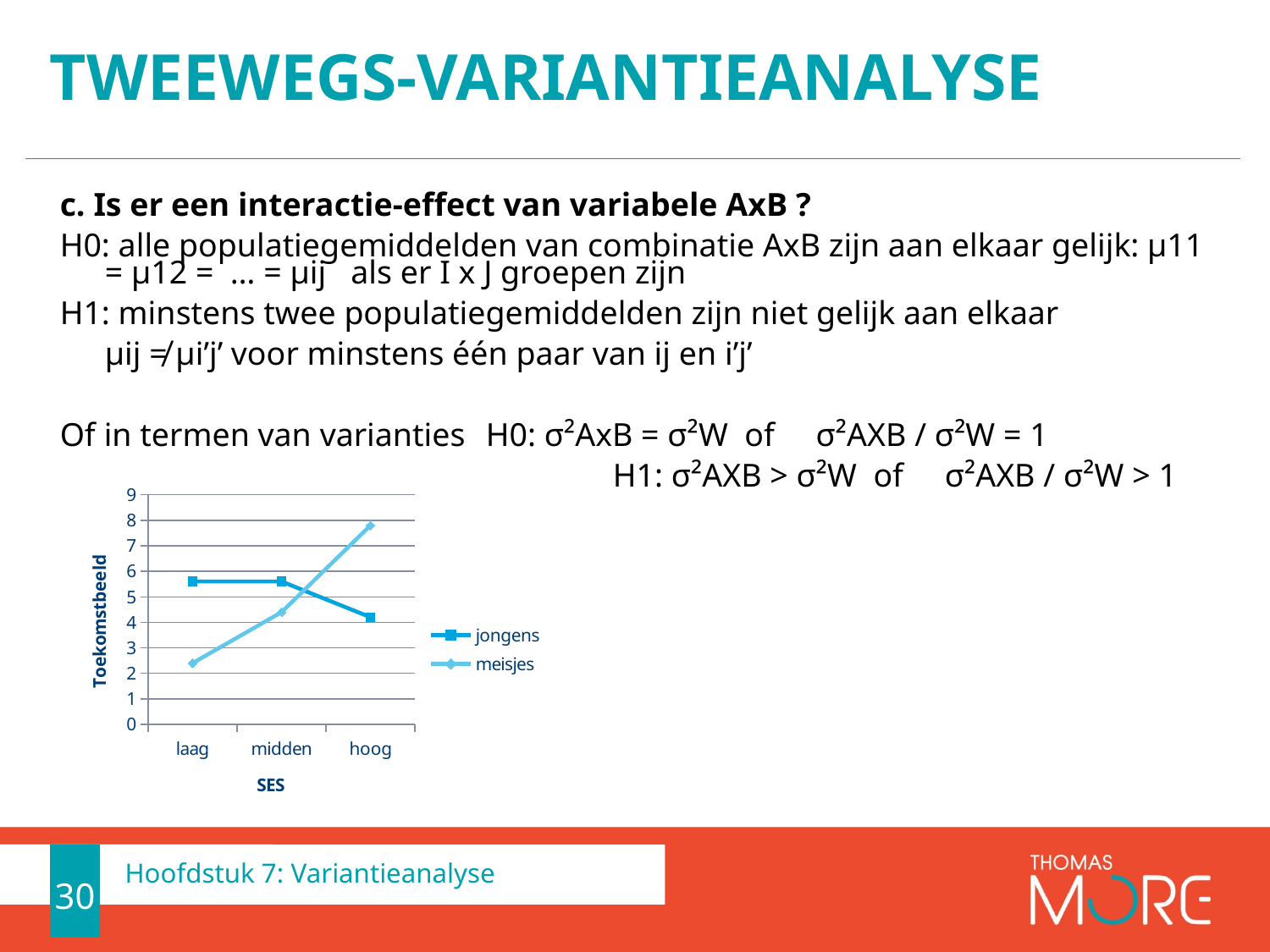
At hoog SES, which series has the larger value, jongens or meisjes? meisjes Is the value for jongens at laag greater or less than 5? greater Is the value for meisjes at hoog greater or less than 7? greater What kind of chart is shown on the slide? line chart Does the meisjes line rise or fall from laag to hoog? rise What is the title of the x axis of the chart? SES How many categories are shown on the x axis of the chart? 3 How many series does the chart legend list? 2 What is the title of the y axis of the chart? Toekomstbeeld Is the value for meisjes at laag greater or less than 3? less At laag SES, which series has the larger value, jongens or meisjes? jongens Does the jongens line rise or fall from midden to hoog? fall